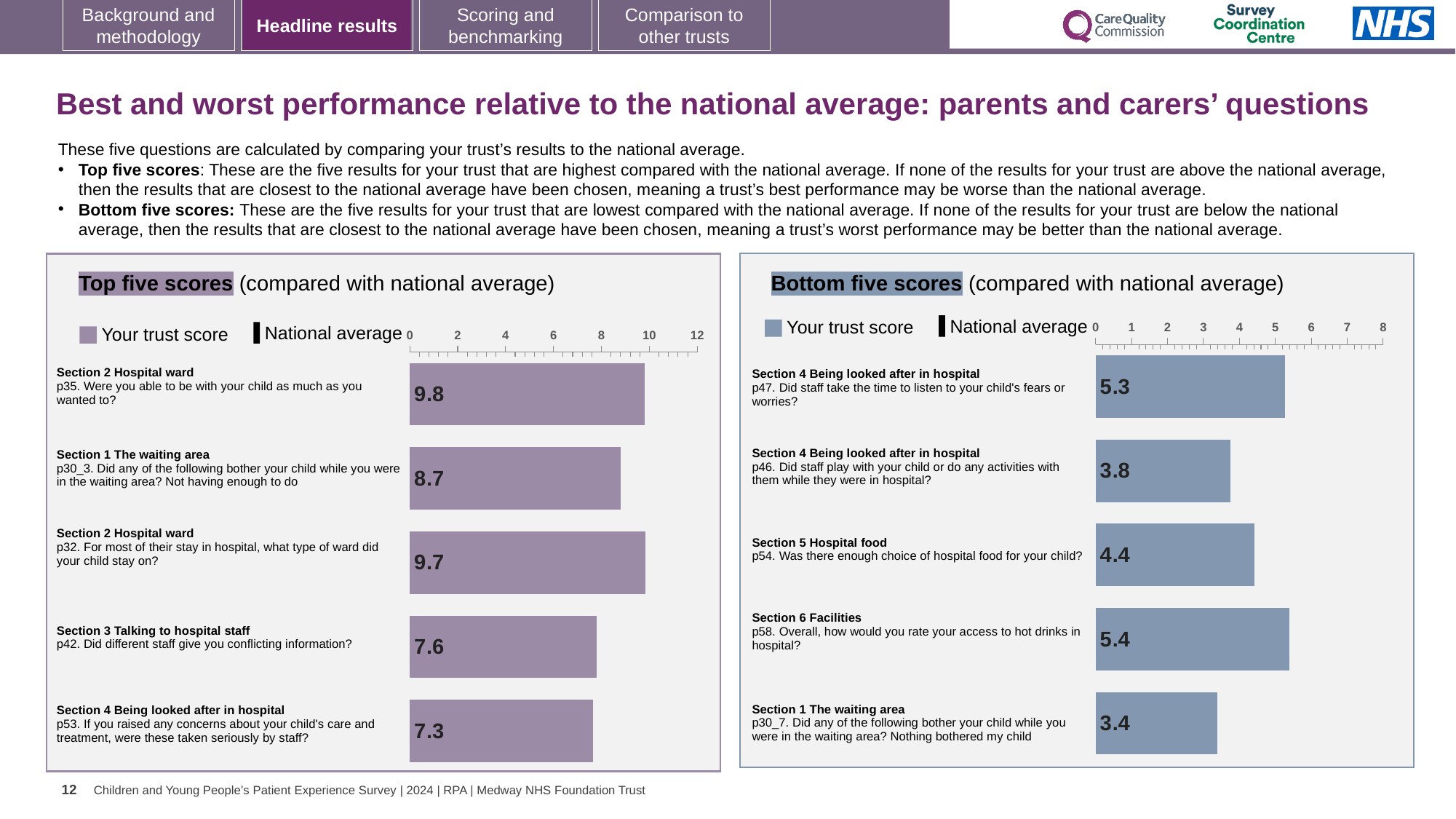
How many series does the legend of the Top five scores chart list? 2 In the Top five scores chart, what is the difference between the trust scores for p35 and p53? 2.5 In the Bottom five scores chart, what is the trust score for p54 (Was there enough choice of hospital food for your child?)? 4.4 How many questions are plotted in the Bottom five scores chart? 5 In the Top five scores chart, which question has the highest trust score? p35. Were you able to be with your child as much as you wanted to? In the Bottom five scores chart, what is the difference between the trust scores for p58 and p46? 1.6 In the Top five scores chart, which has the larger trust score: p30_3 or p32? p32 What type of chart is the Bottom five scores chart? Bar chart In the Bottom five scores chart, which question has the lowest trust score? p30_7. Did any of the following bother your child while you were in the waiting area? Nothing bothered my child In the Bottom five scores chart, what is the trust score for p30_7 (Nothing bothered my child)? 3.4 In the Top five scores chart, what is the trust score for p42 (Did different staff give you conflicting information?)? 7.6 In the Top five scores chart, what is the trust score for p35 (Were you able to be with your child as much as you wanted to?)? 9.8